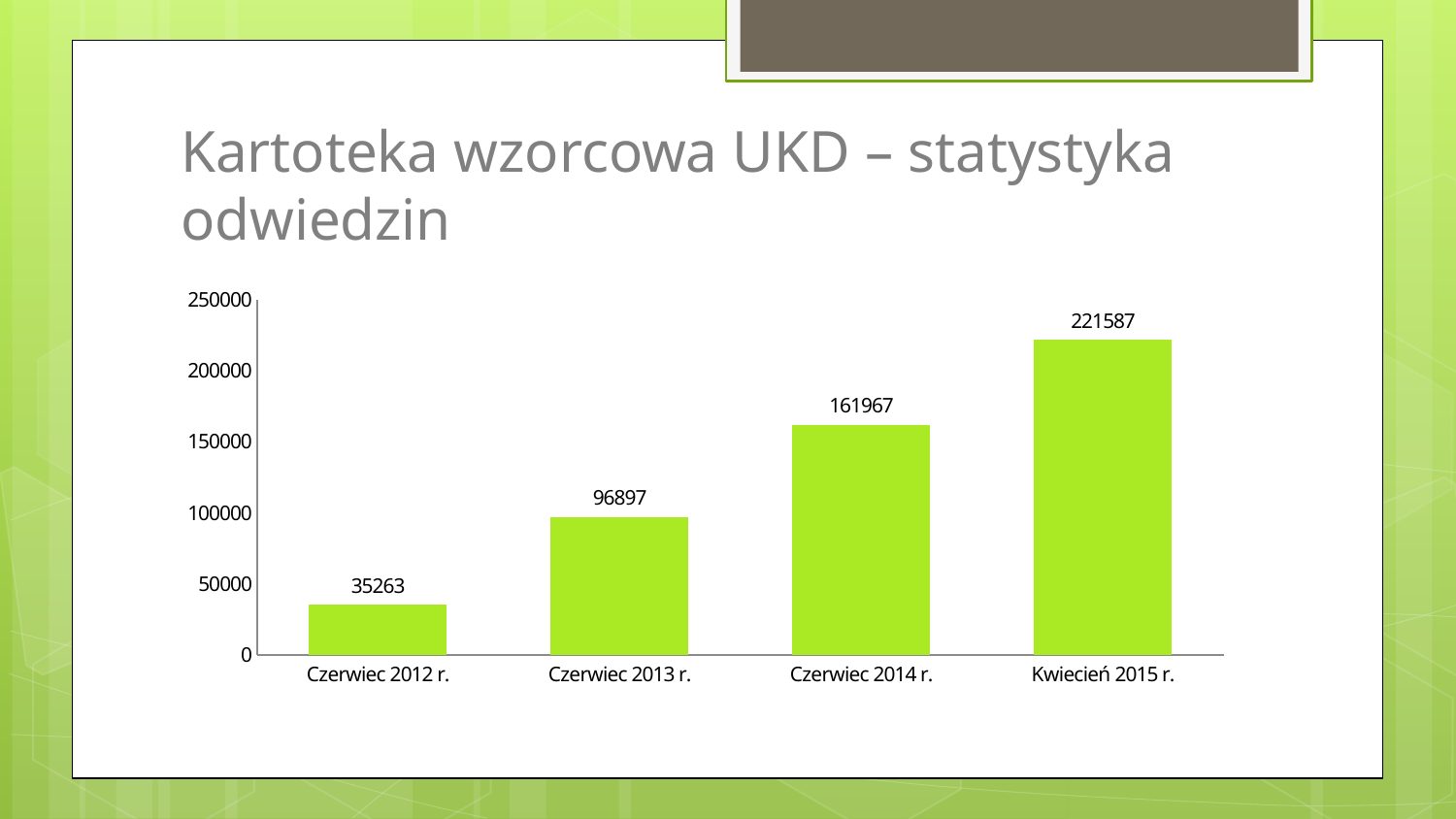
Is the value for Czerwiec 2014 r. greater or less than 150000? greater What kind of chart is shown on the slide? bar chart What is the value for Czerwiec 2013 r.? 96897 Which category has the lowest value? Czerwiec 2012 r. What is the value for Kwiecień 2015 r.? 221587 Which category has the highest value? Kwiecień 2015 r. Which is larger, the value for Czerwiec 2013 r. or Czerwiec 2014 r.? Czerwiec 2014 r. What is the difference between the values for Kwiecień 2015 r. and Czerwiec 2014 r.? 59620 What is the value for Czerwiec 2012 r.? 35263 What is the difference between the values for Czerwiec 2013 r. and Czerwiec 2012 r.? 61634 What is the value for Czerwiec 2014 r.? 161967 How many categories are shown on the x axis? 4